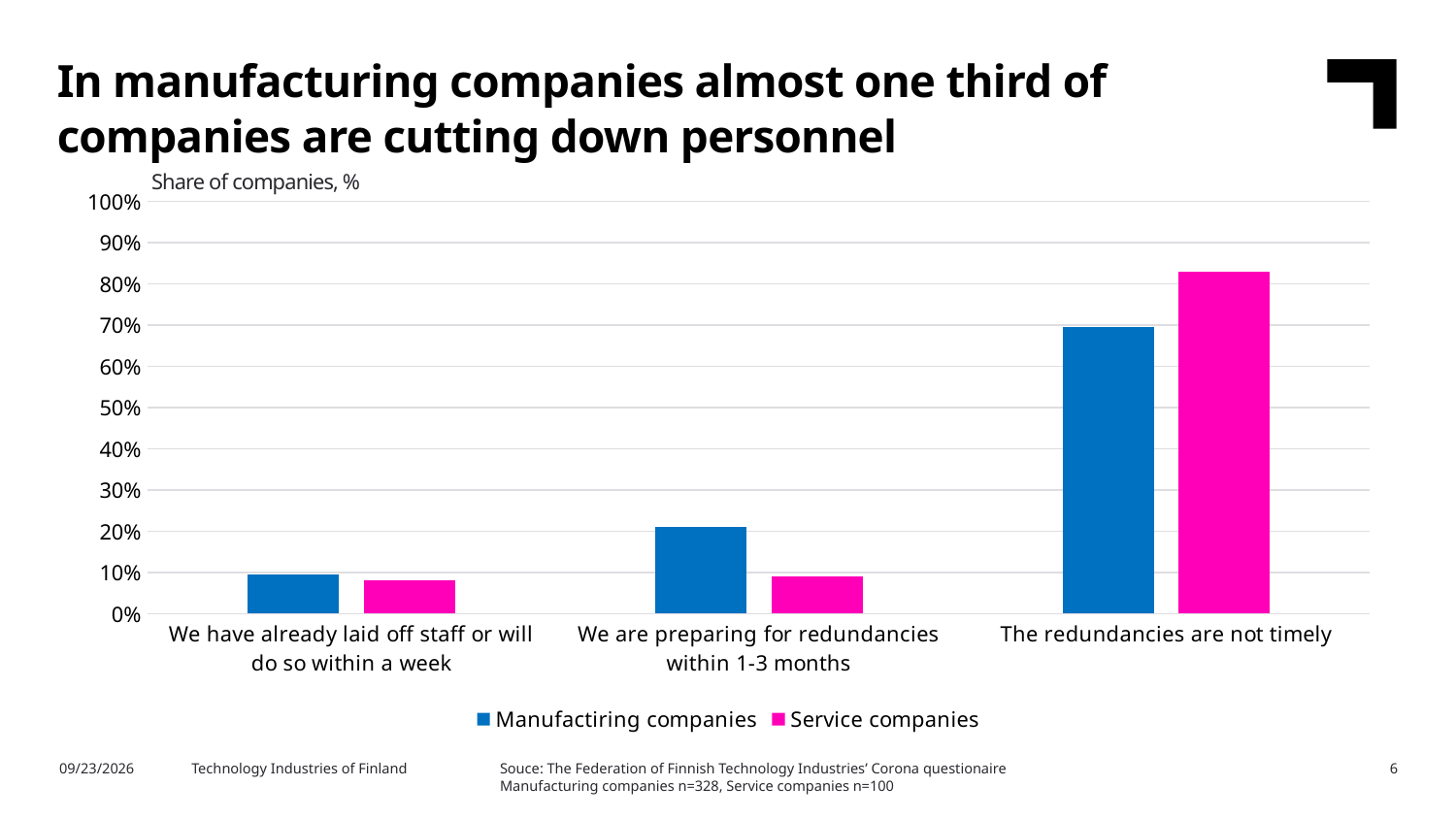
What kind of chart is shown on the slide? Bar chart What label is shown above the y axis of the chart? Share of companies, % For 'The redundancies are not timely', which is larger: Manufactiring companies or Service companies? Service companies Which series and category has the highest bar in the chart? Service companies, The redundancies are not timely Is the value for Service companies in 'The redundancies are not timely' greater or less than 70%? greater For 'We are preparing for redundancies within 1-3 months', which is larger: Manufactiring companies or Service companies? Manufactiring companies Is the value for Service companies in 'We have already laid off staff or will do so within a week' greater or less than 20%? less Within the Manufactiring companies series, which category has the lowest value? We have already laid off staff or will do so within a week Is the value for Manufactiring companies in 'We are preparing for redundancies within 1-3 months' greater or less than 30%? less How many categories are shown on the x axis of the chart? 3 How many series does the chart's legend list? 2